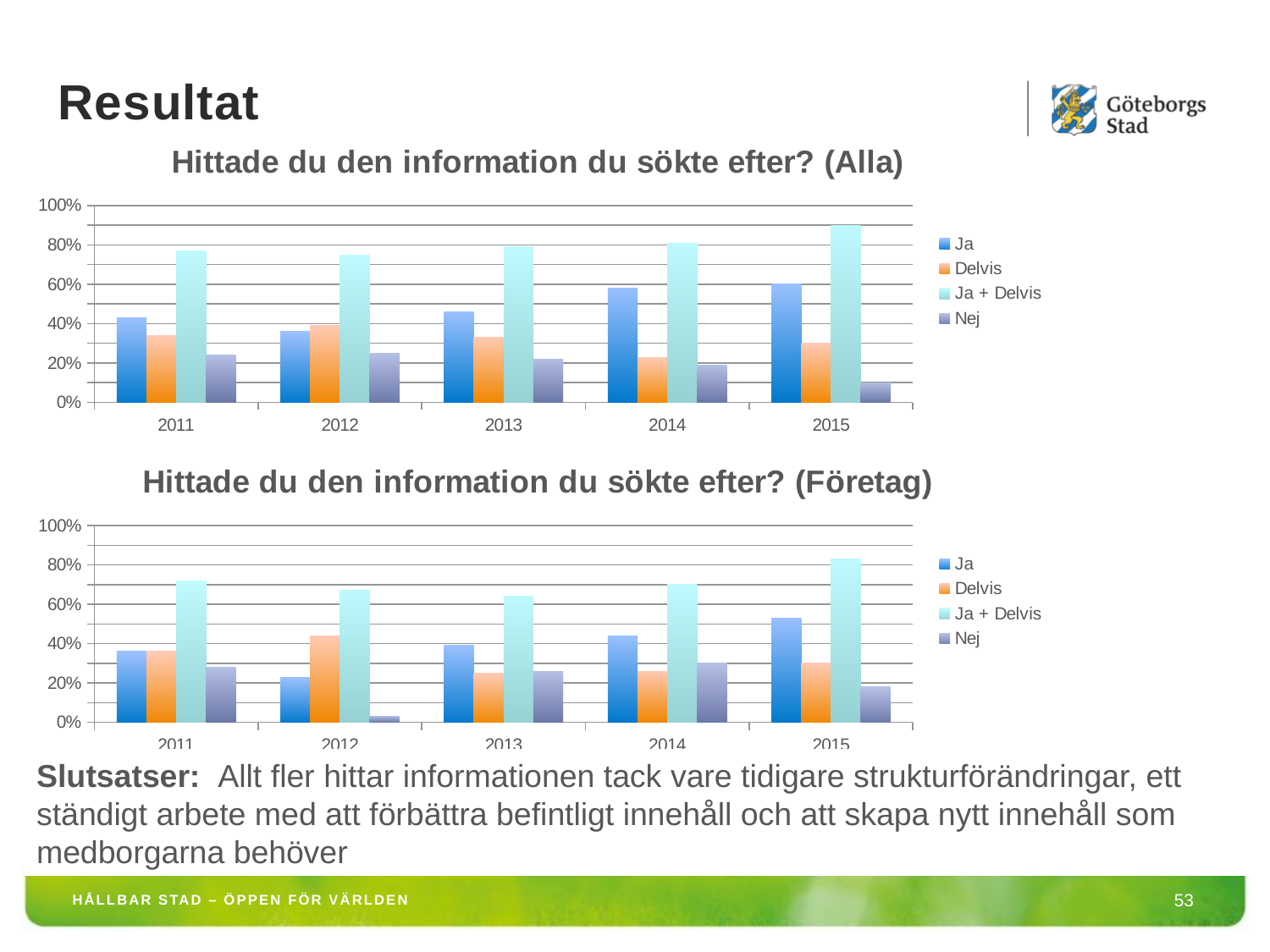
In the top chart (Alla), which year has the lowest value for Nej? 2015 What kind of chart is the top chart titled "Hittade du den information du sökte efter? (Alla)"? Bar chart In the top chart (Alla), how many years are shown on the x axis? 5 In the top chart (Alla), which year has the highest value for Ja + Delvis? 2015 In the bottom chart (Företag), which is larger in 2012: Ja or Delvis? Delvis In the bottom chart (Företag), is the value for Ja + Delvis in 2015 greater or less than 80%? greater In the top chart (Alla), is the value for Nej in 2015 greater or less than 20%? less In the top chart (Alla), how many series does the legend list? 4 In the top chart (Alla), is the value for Ja in 2015 greater or less than 40%? greater What are the four legend entries in the bottom chart (Företag)? Ja, Delvis, Ja + Delvis, Nej In the bottom chart (Företag), which year has the lowest value for Nej? 2012 In the bottom chart (Företag), which year has the highest value for Ja + Delvis? 2015